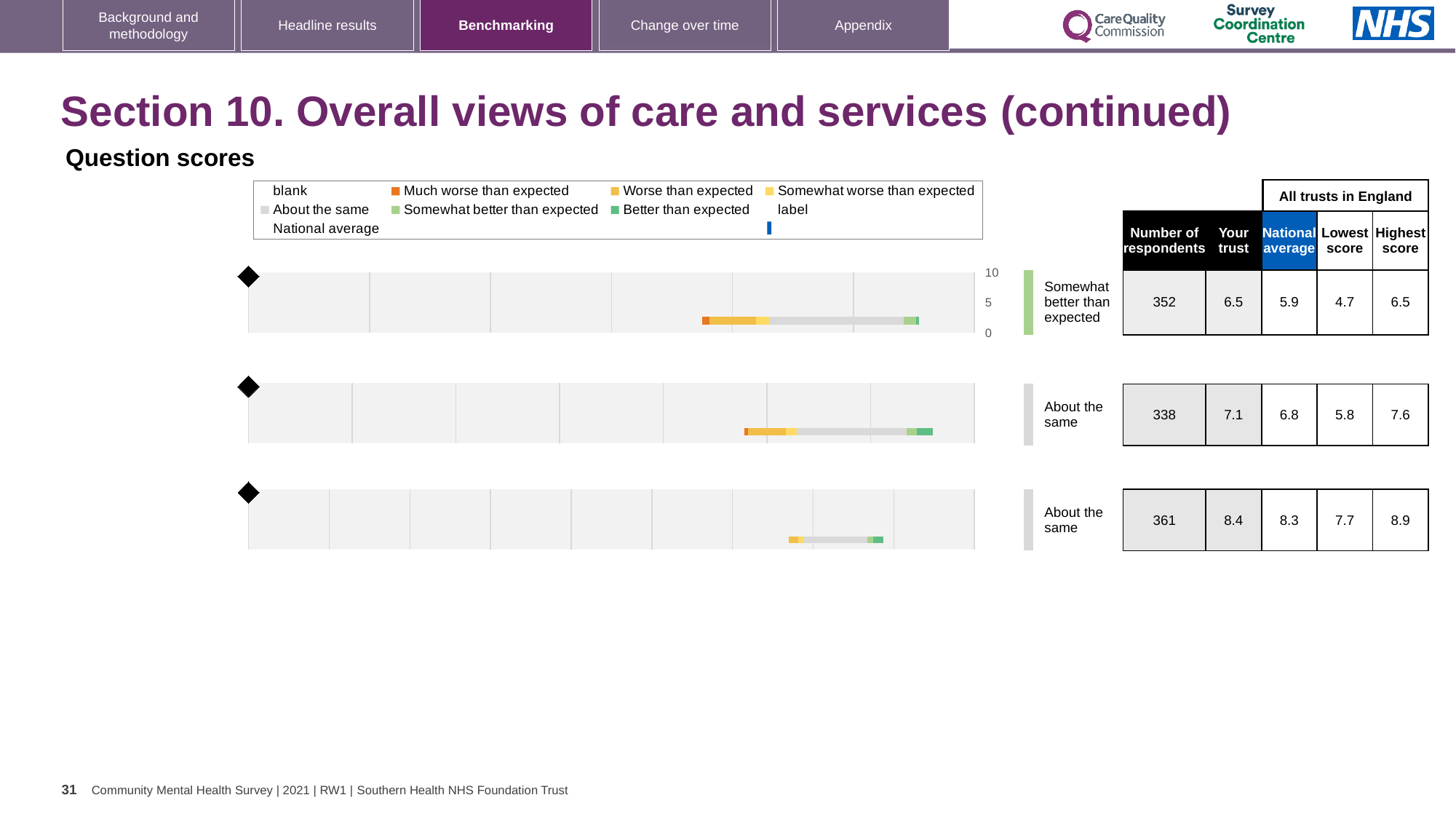
What kind of chart is used for the question scores on this slide? bar chart For the middle chart, what is the lowest score among all trusts in England? 5.8 For the top chart, what is the 'Your trust' score shown in the table? 6.5 For the top chart, what is the difference between the 'Your trust' score and the national average? 0.6 What benchmark category is shown next to the top chart? Somewhat better than expected How many question score charts are shown on the slide? 3 For the middle chart, how many respondents are listed? 338 Which chart has the highest 'Your trust' score: the top, middle or bottom chart? bottom For the bottom chart, what is the highest score among all trusts in England? 8.9 For the top chart, what is the national average score? 5.9 Which chart has the largest number of respondents: the top, middle or bottom chart? bottom For the top chart, is the 'Your trust' score greater or less than 5? greater